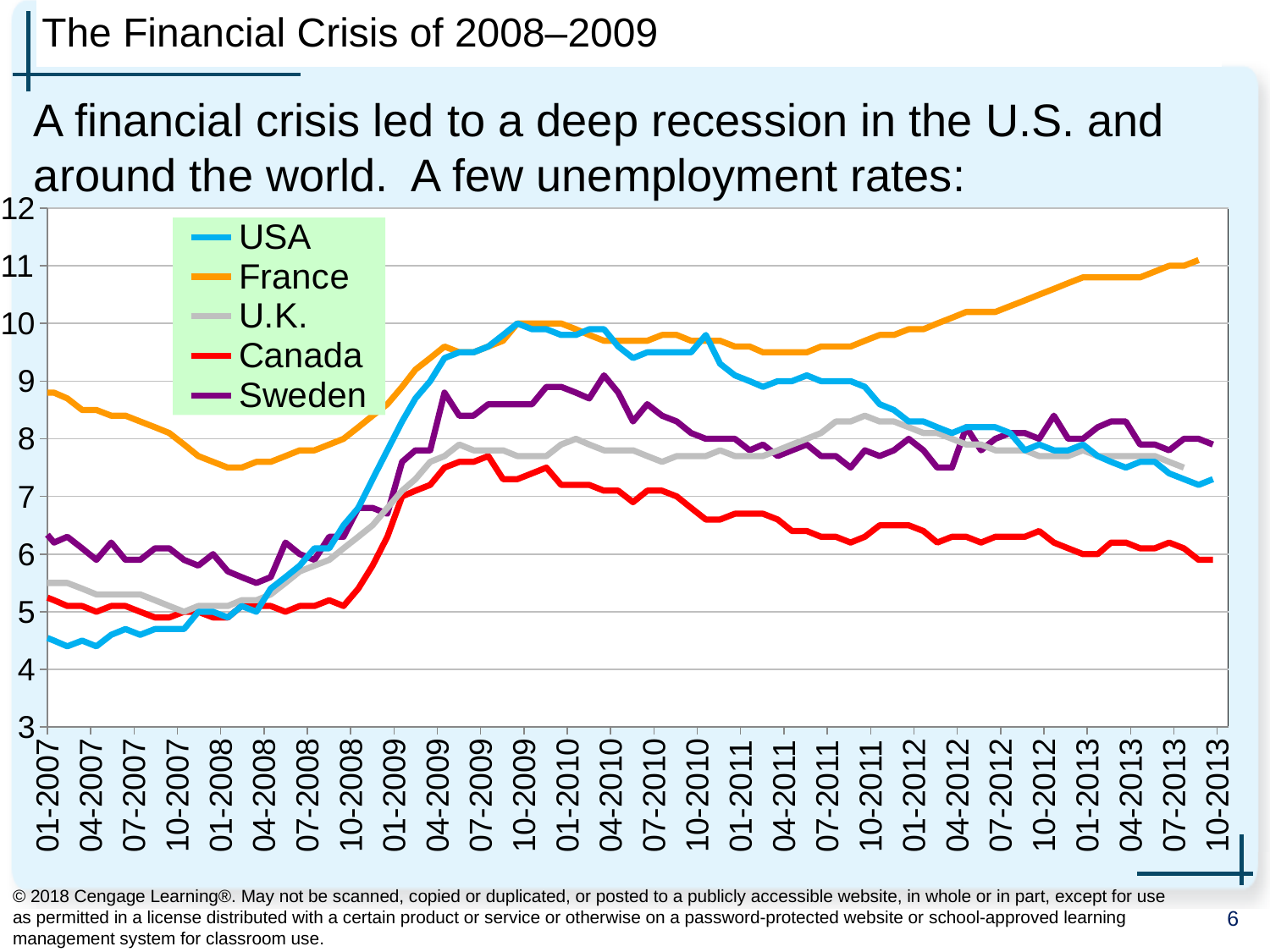
Which country has the highest unemployment rate at 10-2013? France Does the unemployment rate for France rise or fall from 01-2011 to 10-2013? Rises Is the unemployment rate for the USA at 01-2007 greater or less than 5? less Is the unemployment rate for France at 01-2008 greater or less than 8? less What colour is the line for France? Orange At 10-2013, which is higher, the unemployment rate for Sweden or for Canada? Sweden Which country has the lowest unemployment rate at 01-2007? USA How many series does the legend list? 5 Is the unemployment rate for Canada at 10-2013 greater or less than 7? less Which countries are listed in the chart's legend? USA, France, U.K., Canada, Sweden What kind of chart is shown on the slide? Line chart